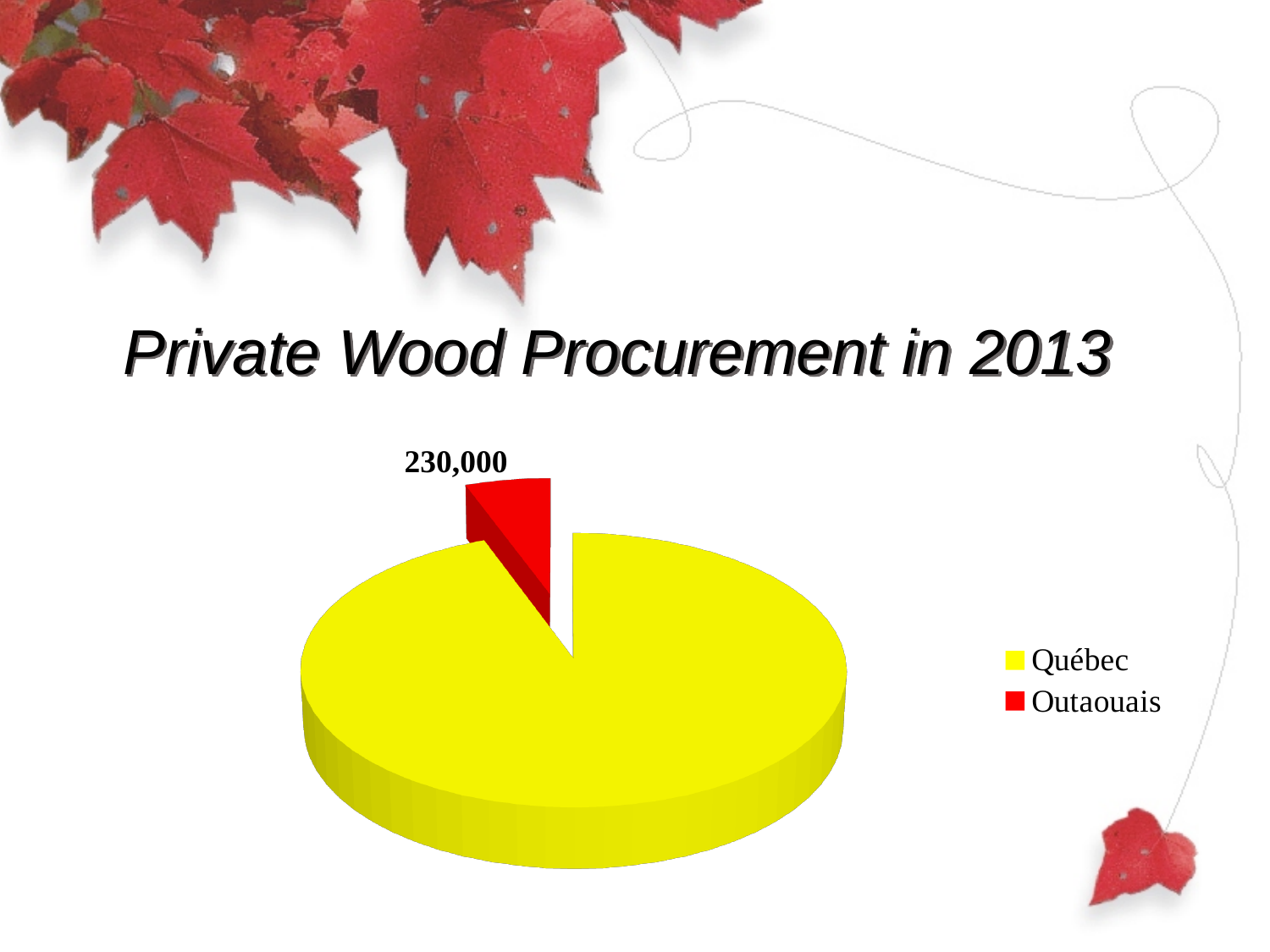
How many slices does the pie chart have? 2 What is the title of the chart on the slide? Private Wood Procurement in 2013 Which slice is the smallest in the pie chart? Outaouais Which is larger, the Québec slice or the Outaouais slice? Québec How many entries does the legend list? 2 Which slice is the largest in the pie chart? Québec What colour is the Outaouais slice? red What value is labelled on the Outaouais slice? 230,000 What kind of chart is shown on the slide? pie chart